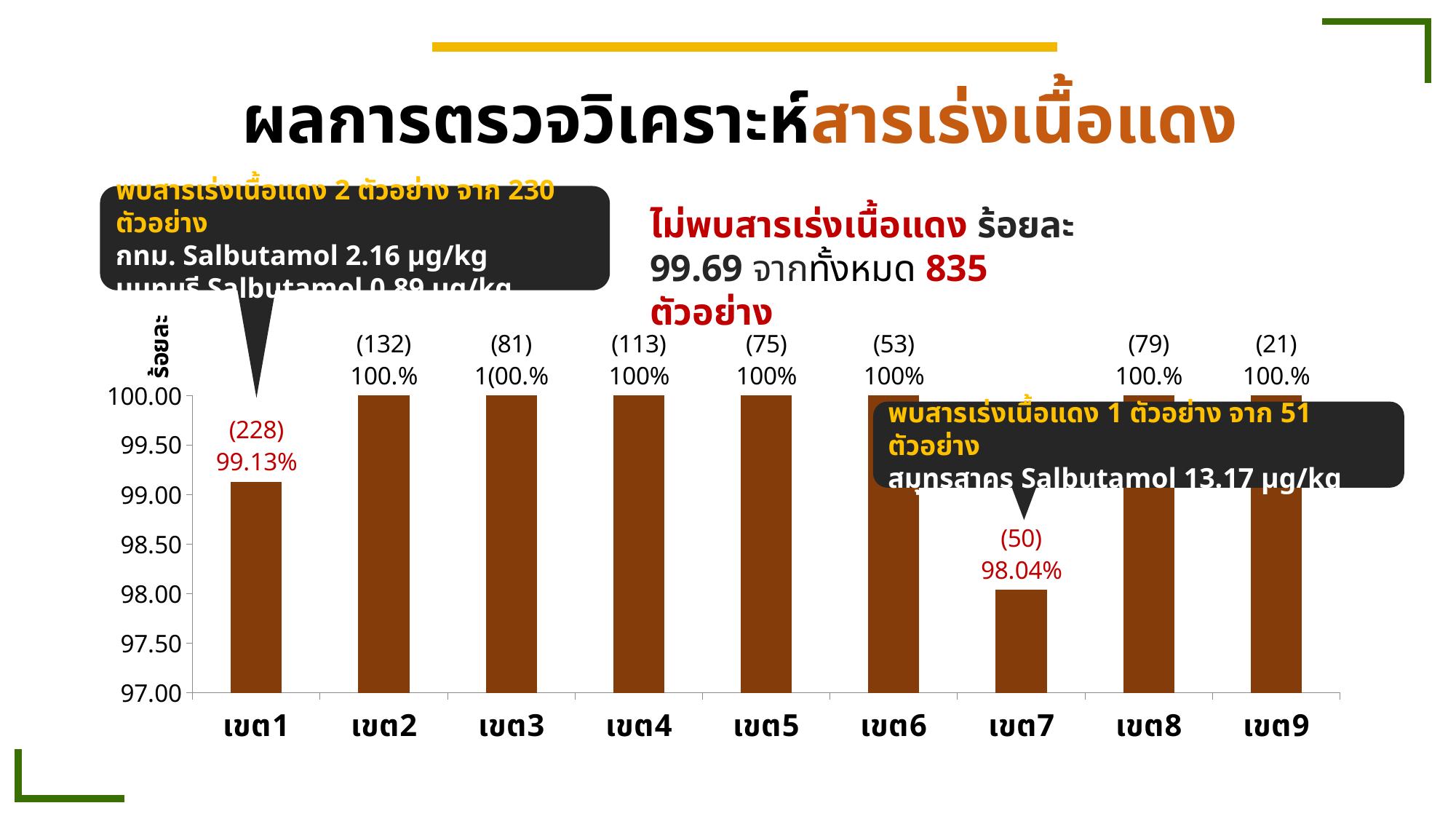
What is the percentage value shown for เขต7? 98.04% Which category has the lowest bar? เขต7 What kind of chart is shown on the slide? bar chart Is the value for เขต7 greater or less than 98.50? less What is the label on the vertical axis? ร้อยละ What is the difference between the percentage values for เขต1 and เขต7? 1.09 What number in parentheses is shown above the bar for เขต1? (228) What number in parentheses is shown above the bar for เขต9? (21) Which is larger, the value for เขต1 or the value for เขต7? เขต1 What number in parentheses is shown above the bar for เขต4? (113) How many categories (เขต) are plotted on the x axis? 9 What is the percentage value shown for เขต1? 99.13%